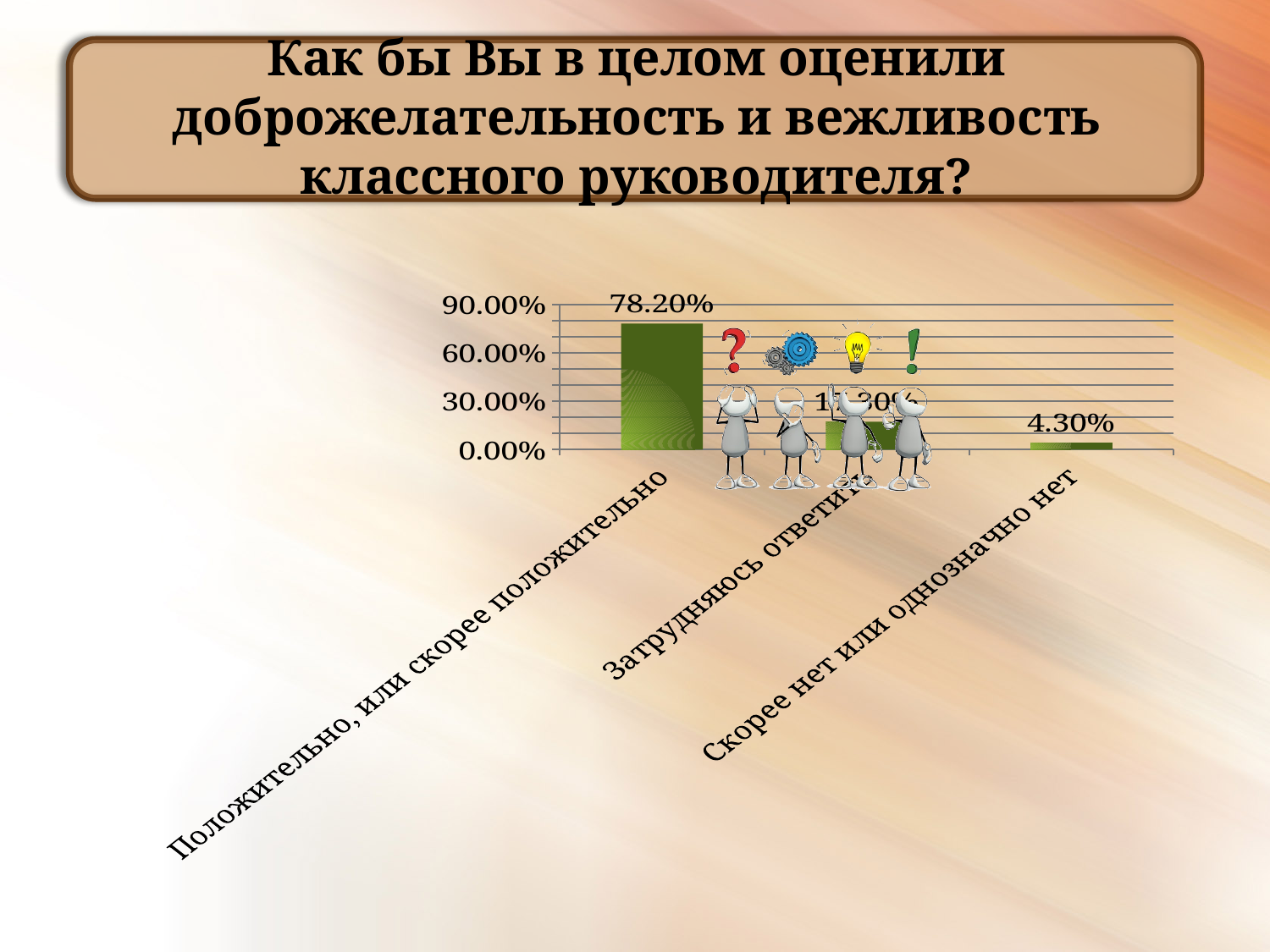
What is the difference between the values for "Положительно, или скорее положительно" and "Скорее нет или однозначно нет"? 73.90% Is the value for "Положительно, или скорее положительно" greater or less than 60.00%? greater What is the value for the category "Положительно, или скорее положительно"? 78.20% Is the value for the middle category ("Затрудняюсь ответить") greater or less than 30.00%? less What kind of chart is shown on the slide? bar chart Do the values rise or fall from left to right along the x axis? fall Which category has the lowest value? Скорее нет или однозначно нет What is the highest tick label shown on the vertical axis? 90.00% Which category has the highest value? Положительно, или скорее положительно Which is larger: the value for "Положительно, или скорее положительно" or for "Скорее нет или однозначно нет"? Положительно, или скорее положительно What is the value for the category "Скорее нет или однозначно нет"? 4.30% How many categories are shown on the chart? 3